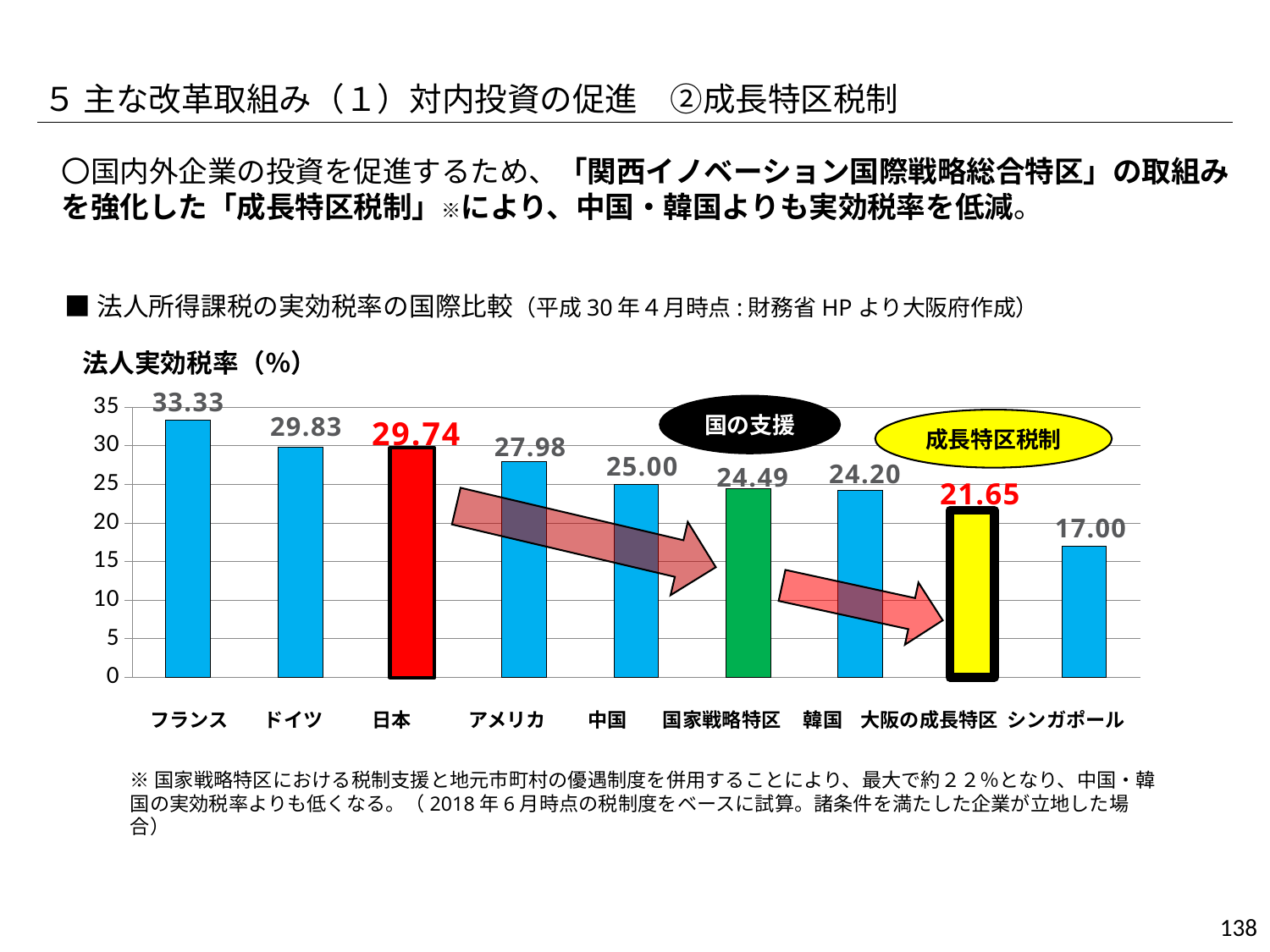
What is the title of the chart? 法人実効税率（%） What kind of chart is shown on the slide? bar chart Which category has the highest value in the chart? フランス Which is larger, the value for 中国 or the value for 大阪の成長特区? 中国 How many categories are shown in the chart? 9 What is the value for 中国 in the chart? 25.00 What is the value for 国家戦略特区 in the chart? 24.49 What is the difference between the values for 日本 and 大阪の成長特区? 8.09 Which category has the lowest value in the chart? シンガポール What is the value for フランス in the 法人実効税率（%） chart? 33.33 What is the value for 大阪の成長特区 in the chart? 21.65 What is the difference between the values for 韓国 and 大阪の成長特区? 2.55